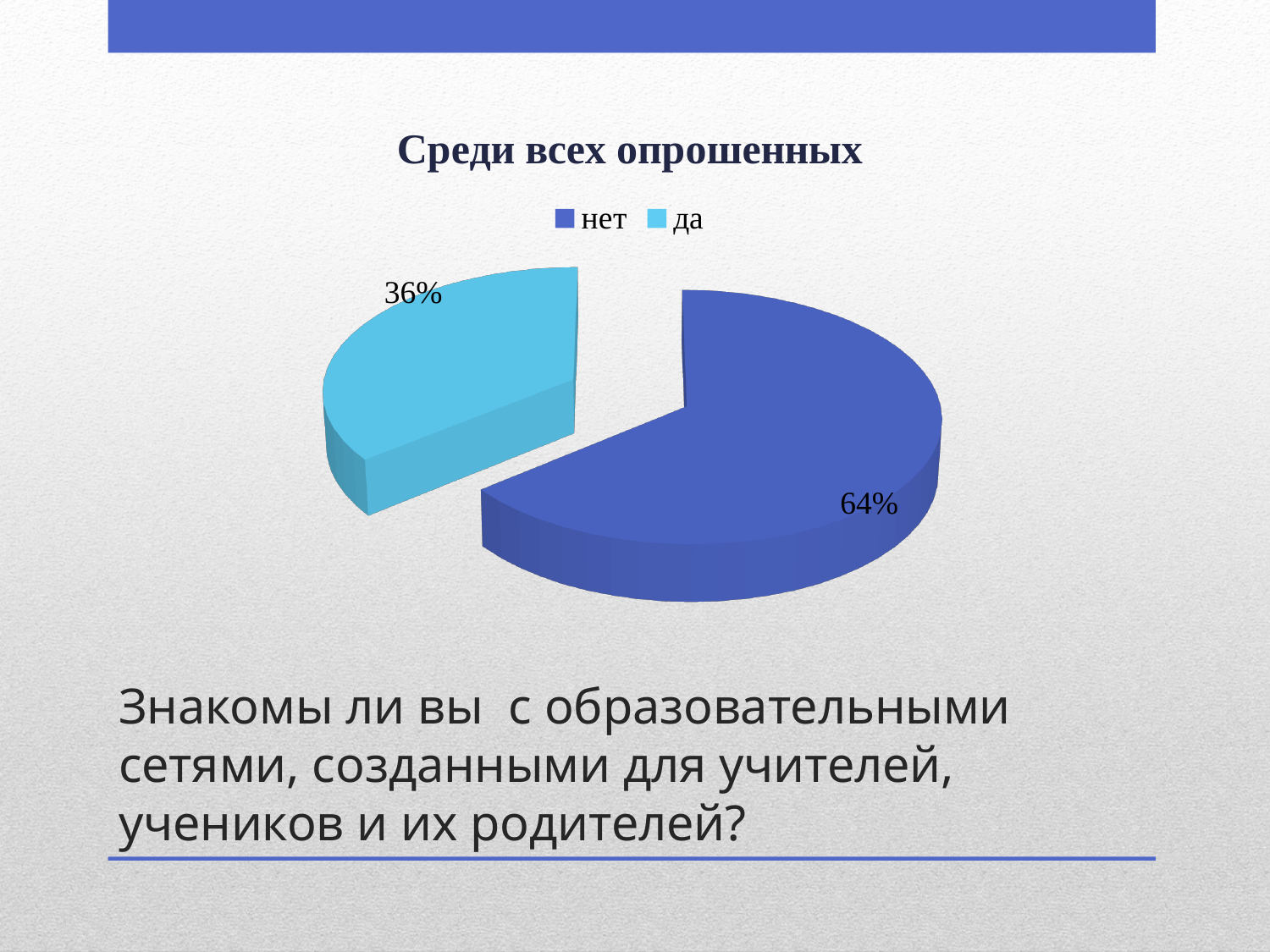
What kind of chart is shown on the slide? pie chart What is the title of the chart? Среди всех опрошенных How many entries does the legend list? 2 What share of the pie does the "нет" slice represent? 64% What share of the pie does the "да" slice represent? 36% How many categories does the pie chart have? 2 Which is larger, the "да" slice or the "нет" slice? нет What is the difference in percentage points between the "нет" and "да" slices? 28 percentage points Which category has the smallest slice of the pie? да What colour is the "да" slice? light blue Is the share for "нет" greater or less than 50%? greater Which category has the largest slice of the pie? нет